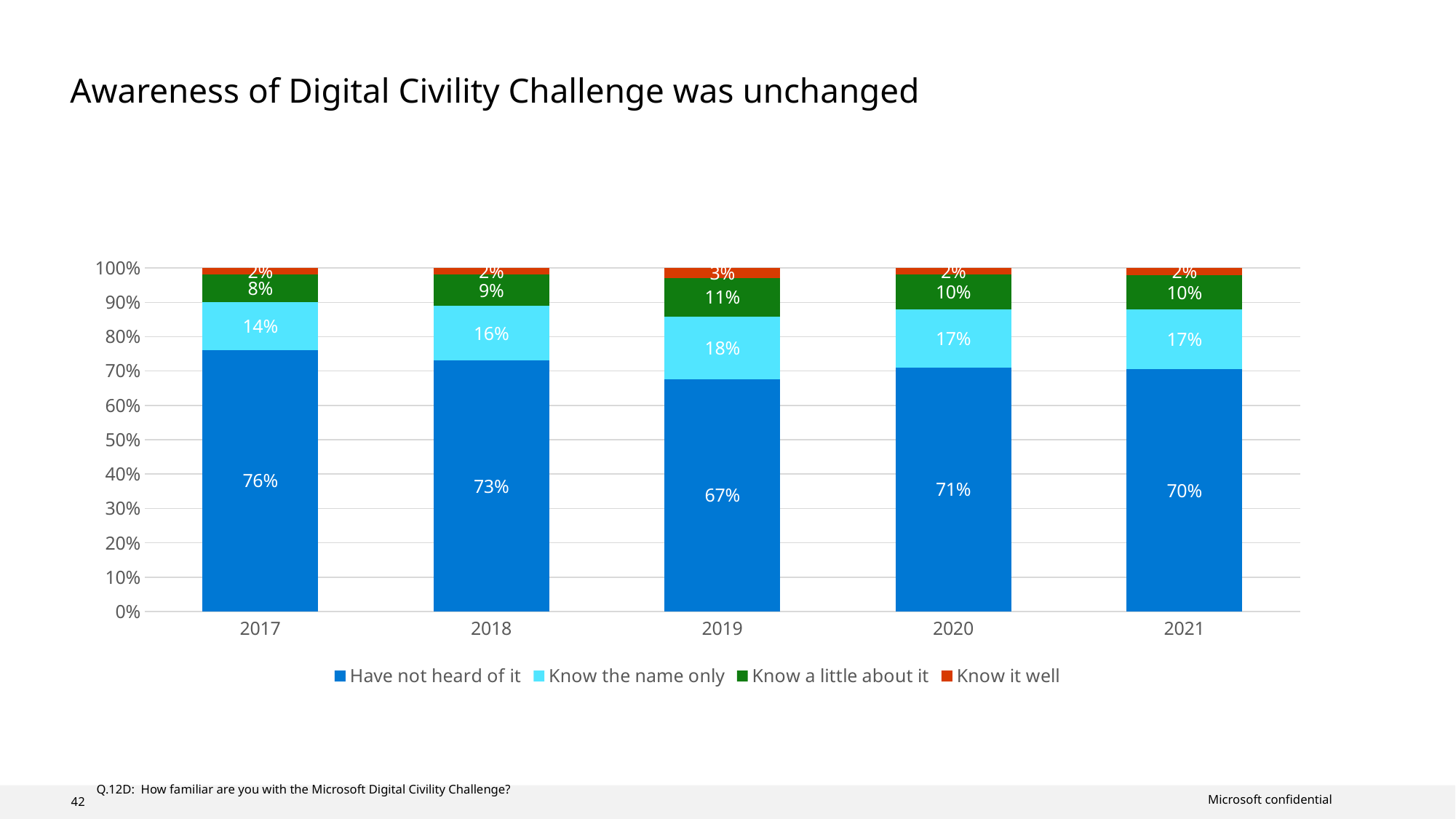
What percentage of respondents had not heard of the Digital Civility Challenge in 2017? 76% In which year was the 'Have not heard of it' share lowest? 2019 In which year was the 'Have not heard of it' share highest? 2017 What is the value for 'Know a little about it' in 2021? 10% How many series does the legend list? 4 How many years are shown on the x axis? 5 What is the difference between the 'Have not heard of it' values for 2017 and 2021? 6% What kind of chart is shown on the slide? Stacked bar chart What is the value for 'Know the name only' in 2019? 18% What is the title of the slide? Awareness of Digital Civility Challenge was unchanged What is the value for 'Know it well' in 2019? 3% Which is larger: 'Know the name only' in 2018 or in 2020? 2020